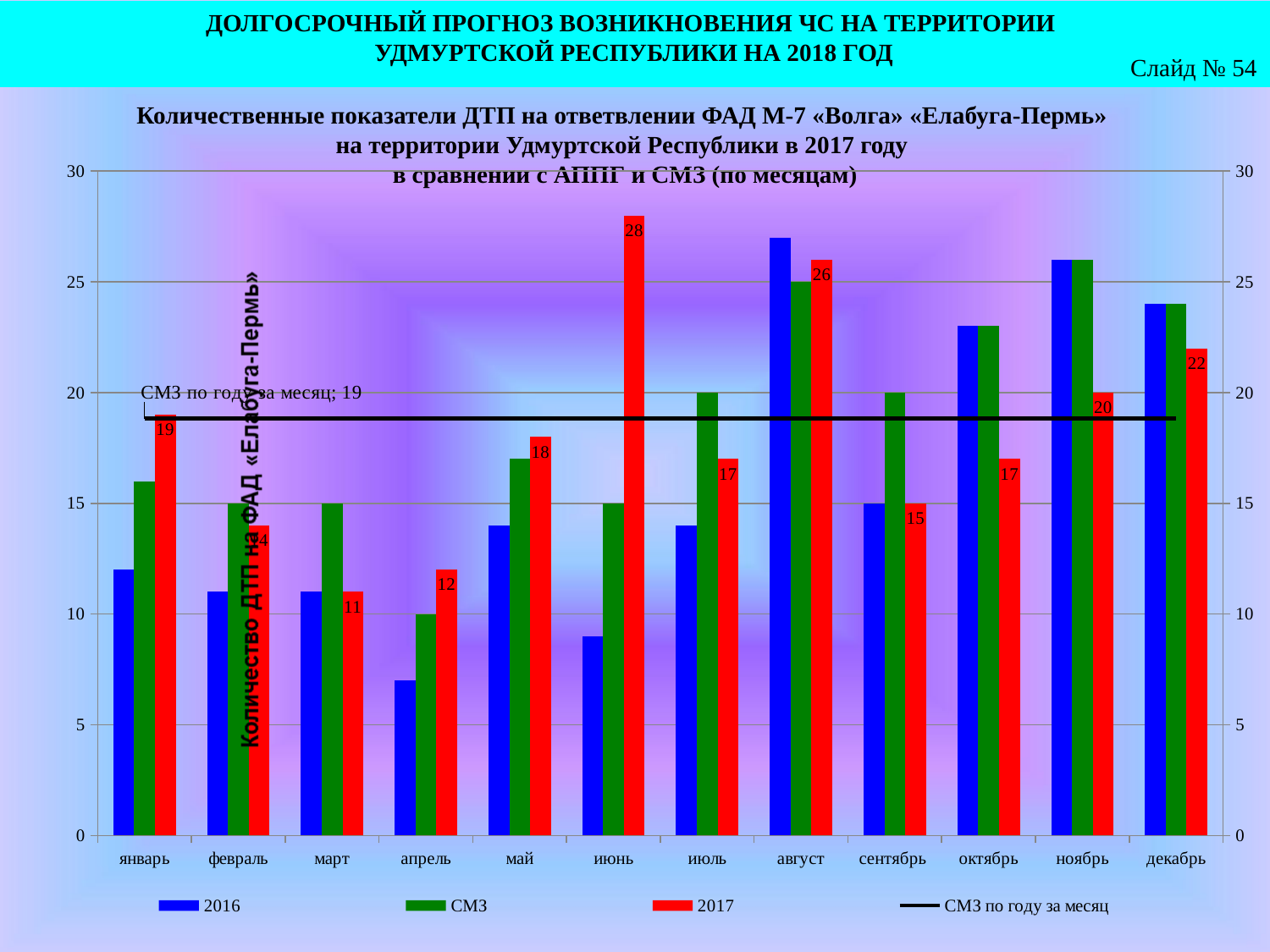
How many entries does the legend list? 4 Which is larger, the 2017 value for август or the 2017 value for ноябрь? август How many months are shown on the x axis? 12 In which month is the 2017 value the highest? июнь In which month is the 2017 value the lowest? март Is the value for 2016 in апрель greater or less than 10? less What kind of chart is shown on the slide? combination bar and line chart What value does the horizontal line 'СМЗ по году за месяц' show? 19 What colour are the bars for the 2017 series? red What is the value for 2017 in июнь? 28 What is the difference between the 2017 values for июнь and март? 17 Is the value for 2016 in август greater or less than 25? greater